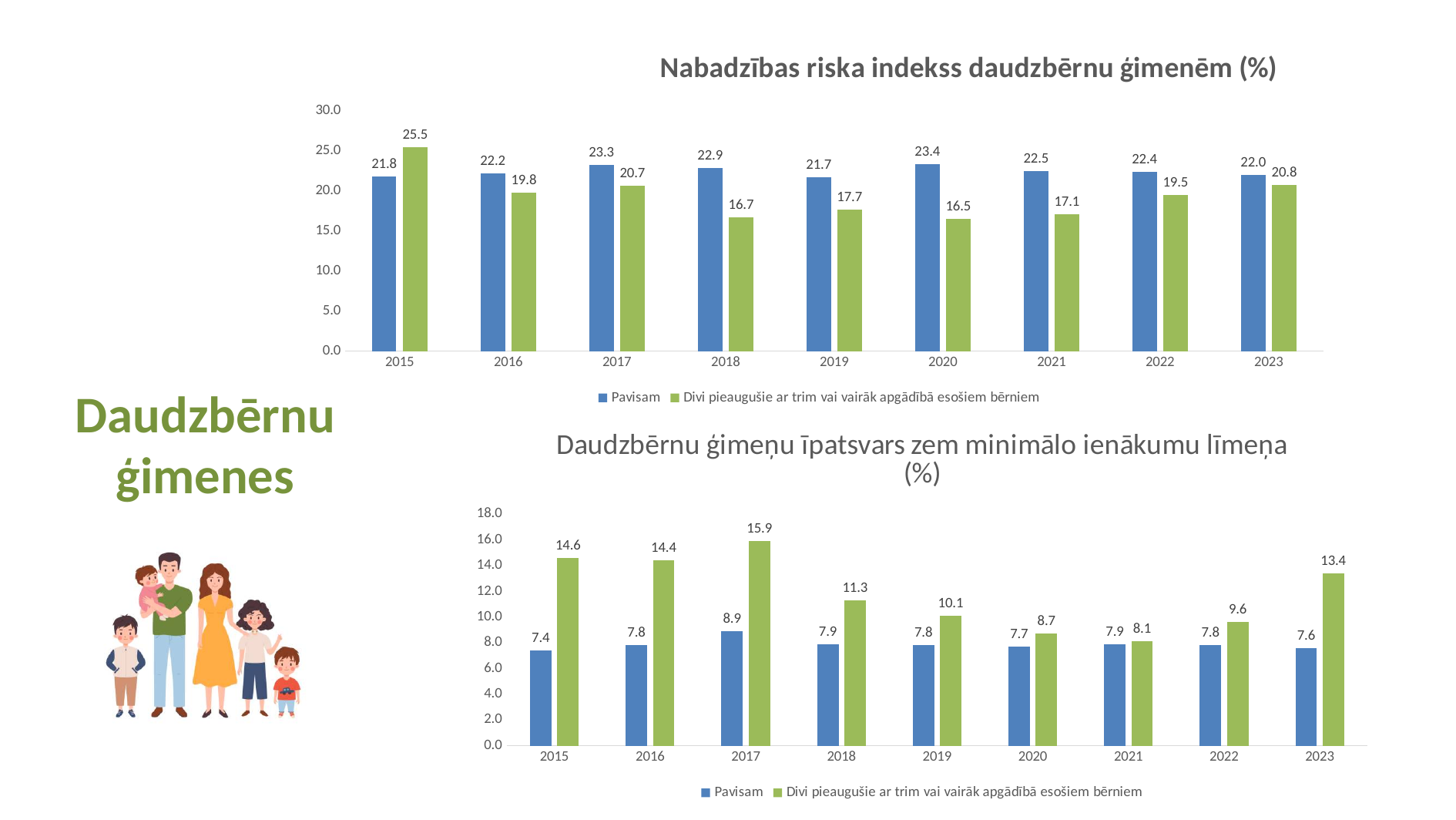
In the top chart 'Nabadzības riska indekss daudzbērnu ģimenēm (%)', what is the value for Pavisam in 2017? 23.3 In the bottom chart 'Daudzbērnu ģimeņu īpatsvars zem minimālo ienākumu līmeņa (%)', how many series does the legend list? 2 In the top chart 'Nabadzības riska indekss daudzbērnu ģimenēm (%)', which year has the lowest value for Pavisam? 2019 In the top chart 'Nabadzības riska indekss daudzbērnu ģimenēm (%)', what is the value for 'Divi pieaugušie ar trim vai vairāk apgādībā esošiem bērniem' in 2020? 16.5 In the bottom chart 'Daudzbērnu ģimeņu īpatsvars zem minimālo ienākumu līmeņa (%)', which is larger in 2022: the Pavisam value or the 'Divi pieaugušie ar trim vai vairāk apgādībā esošiem bērniem' value? Divi pieaugušie ar trim vai vairāk apgādībā esošiem bērniem In the top chart 'Nabadzības riska indekss daudzbērnu ģimenēm (%)', which year has the highest value for 'Divi pieaugušie ar trim vai vairāk apgādībā esošiem bērniem'? 2015 In the bottom chart 'Daudzbērnu ģimeņu īpatsvars zem minimālo ienākumu līmeņa (%)', what is the value for 'Divi pieaugušie ar trim vai vairāk apgādībā esošiem bērniem' in 2017? 15.9 In the bottom chart 'Daudzbērnu ģimeņu īpatsvars zem minimālo ienākumu līmeņa (%)', what is the value for Pavisam in 2023? 7.6 What kind of chart is the bottom chart 'Daudzbērnu ģimeņu īpatsvars zem minimālo ienākumu līmeņa (%)'? Bar chart In the bottom chart 'Daudzbērnu ģimeņu īpatsvars zem minimālo ienākumu līmeņa (%)', which year has the lowest value for 'Divi pieaugušie ar trim vai vairāk apgādībā esošiem bērniem'? 2021 In the top chart 'Nabadzības riska indekss daudzbērnu ģimenēm (%)', what is the difference between the Pavisam value and the 'Divi pieaugušie ar trim vai vairāk apgādībā esošiem bērniem' value in 2018? 6.2 In the top chart 'Nabadzības riska indekss daudzbērnu ģimenēm (%)', how many years are shown on the x axis? 9